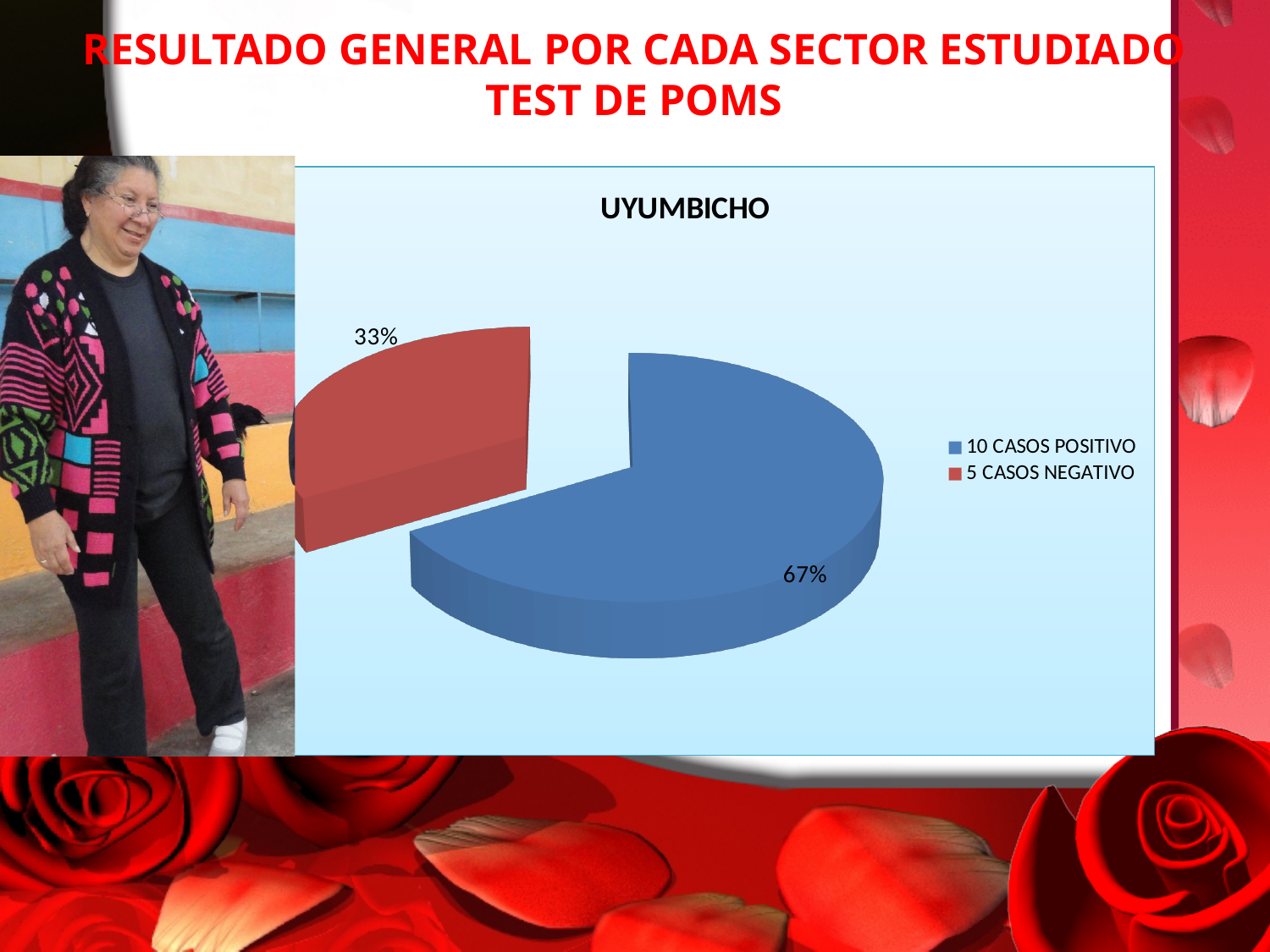
How many slices does the pie chart have? 2 What share of the pie does the 5 CASOS NEGATIVO slice represent? 33% Which slice is the largest in the pie chart? 10 CASOS POSITIVO What kind of chart is shown on the slide? pie chart What percentage is shown for the 10 CASOS POSITIVO slice? 67% How many entries does the legend list? 2 What percentage is shown for the 5 CASOS NEGATIVO slice? 33% What colour is the 10 CASOS POSITIVO slice? blue What is the title of the chart? UYUMBICHO What is the difference in percentage points between the 10 CASOS POSITIVO slice and the 5 CASOS NEGATIVO slice? 34 Which slice is the smallest in the pie chart? 5 CASOS NEGATIVO Which is larger, the 10 CASOS POSITIVO slice or the 5 CASOS NEGATIVO slice? 10 CASOS POSITIVO